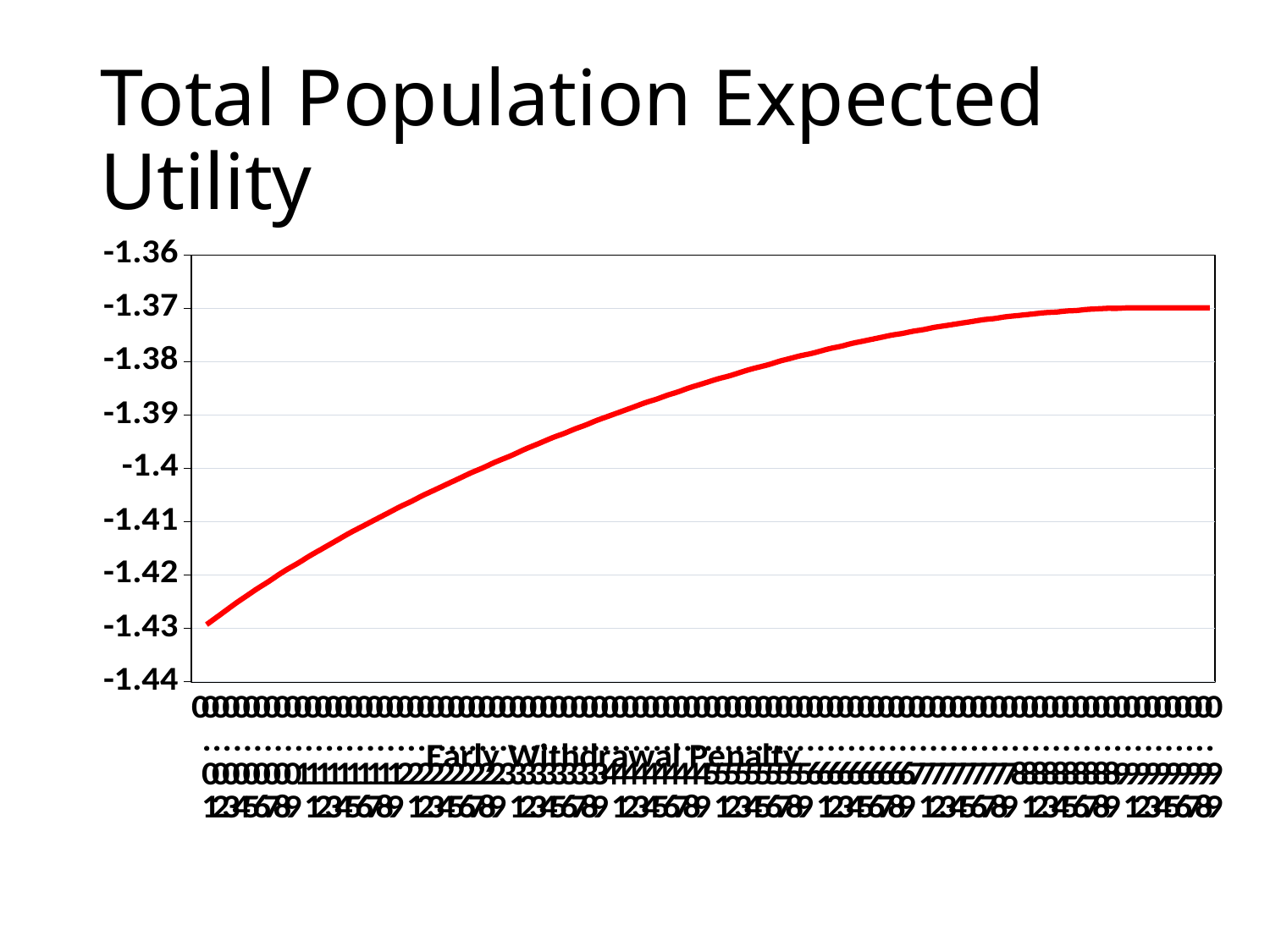
Where along the x axis does the line reach its highest value, at the left end or the right end? right end Which end of the line, left or right, has the higher value? right Is the value at the rightmost point of the line greater or less than -1.38? greater Is the value at the rightmost point of the line greater or less than -1.36? less What is the title of the chart? Total Population Expected Utility Is the value at the leftmost point of the line greater or less than -1.44? greater What kind of chart is shown on the slide? line chart What is the label on the x axis of the chart? Early Withdrawal Penalty Where along the x axis does the line reach its lowest value, at the left end or the right end? left end Do the values rise or fall as you move from left to right along the x axis? rise